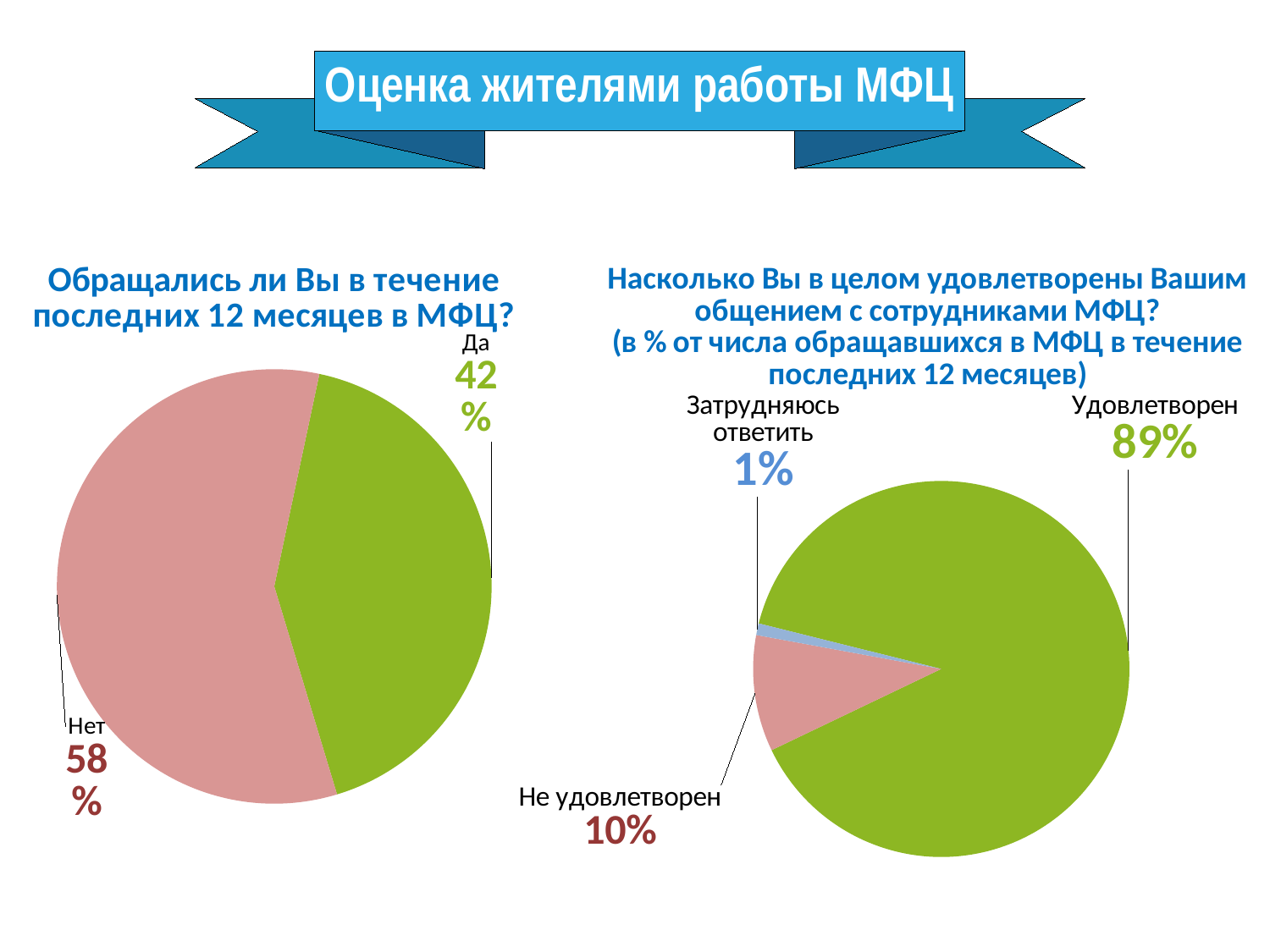
In the right chart (Насколько Вы в целом удовлетворены Вашим общением с сотрудниками МФЦ?), what share of respondents answered "Затрудняюсь ответить"? 1% In the right chart (Насколько Вы в целом удовлетворены Вашим общением с сотрудниками МФЦ?), what share of respondents answered "Не удовлетворен"? 10% In the left chart (Обращались ли Вы в течение последних 12 месяцев в МФЦ?), what share of respondents answered "Нет"? 58% In the right chart (Насколько Вы в целом удовлетворены Вашим общением с сотрудниками МФЦ?), what share of respondents answered "Удовлетворен"? 89% In the right chart (Насколько Вы в целом удовлетворены Вашим общением с сотрудниками МФЦ?), what is the difference in percentage points between "Удовлетворен" and "Не удовлетворен"? 79 In the left chart (Обращались ли Вы в течение последних 12 месяцев в МФЦ?), what share of respondents answered "Да"? 42% What type of chart is the right chart (Насколько Вы в целом удовлетворены Вашим общением с сотрудниками МФЦ?)? Pie chart In the left chart (Обращались ли Вы в течение последних 12 месяцев в МФЦ?), how many slices does the pie have? 2 In the right chart (Насколько Вы в целом удовлетворены Вашим общением с сотрудниками МФЦ?), how many slices does the pie have? 3 In the right chart (Насколько Вы в целом удовлетворены Вашим общением с сотрудниками МФЦ?), which answer has the smallest share? Затрудняюсь ответить In the left chart (Обращались ли Вы в течение последних 12 месяцев в МФЦ?), what is the difference in percentage points between "Нет" and "Да"? 16 In the left chart (Обращались ли Вы в течение последних 12 месяцев в МФЦ?), which answer has the larger share? Нет